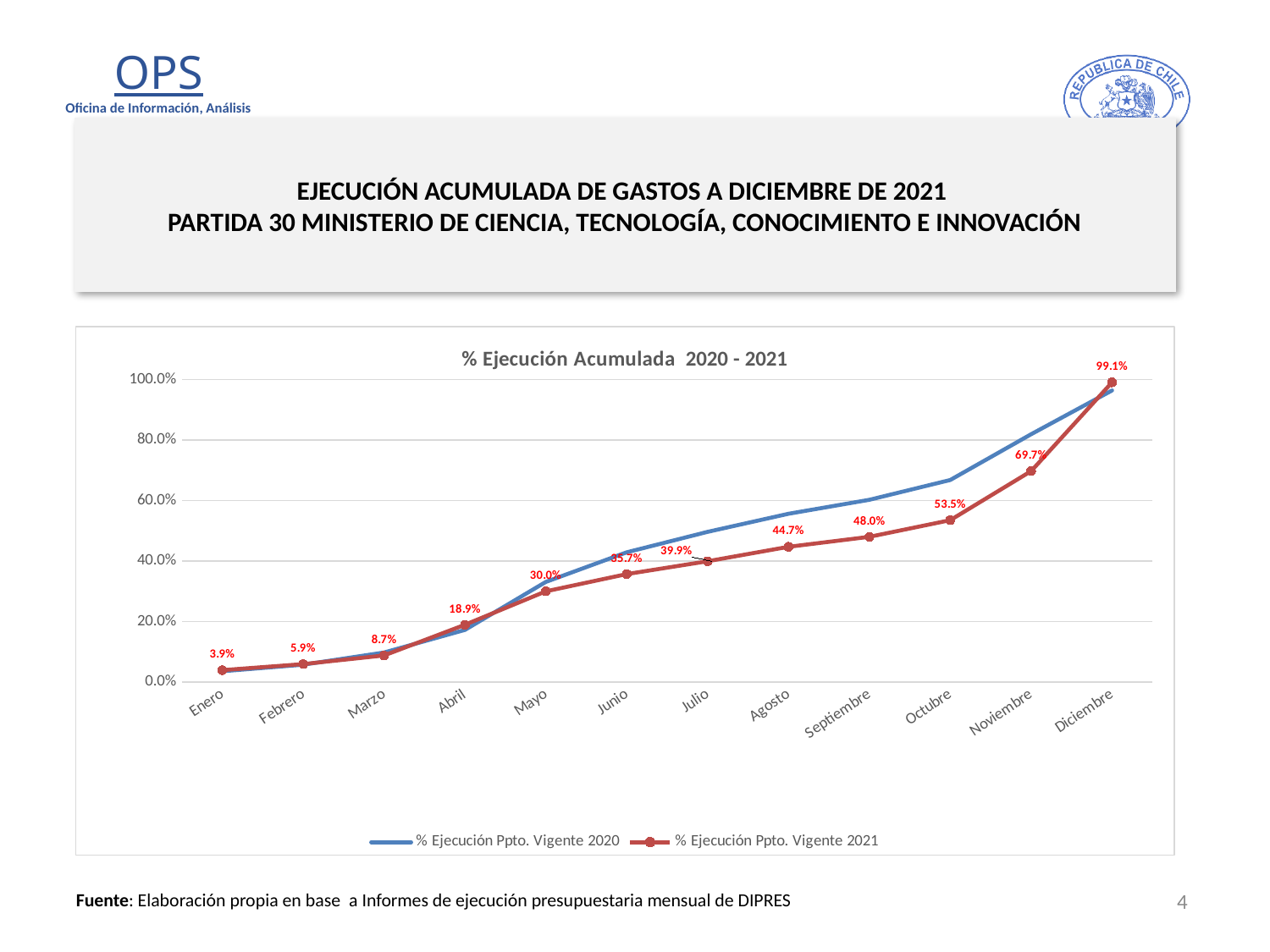
Which month has the highest value for % Ejecución Ppto. Vigente 2021? Diciembre Do the values for % Ejecución Ppto. Vigente 2021 rise or fall from Enero to Diciembre? Rise Is the value for % Ejecución Ppto. Vigente 2020 in Octubre greater or less than 60.0%? greater What is the difference between the % Ejecución Ppto. Vigente 2021 values for Diciembre and Noviembre? 29.4% How many months are shown on the x axis of the chart? 12 How many series does the chart legend list? 2 In Noviembre, which series has the larger value: % Ejecución Ppto. Vigente 2020 or % Ejecución Ppto. Vigente 2021? % Ejecución Ppto. Vigente 2020 What is the value for % Ejecución Ppto. Vigente 2021 in Septiembre? 48.0% What kind of chart is shown on the slide? Line chart What is the value for % Ejecución Ppto. Vigente 2021 in Diciembre? 99.1% Which month has the lowest value for % Ejecución Ppto. Vigente 2021? Enero What is the value for % Ejecución Ppto. Vigente 2021 in Abril? 18.9%